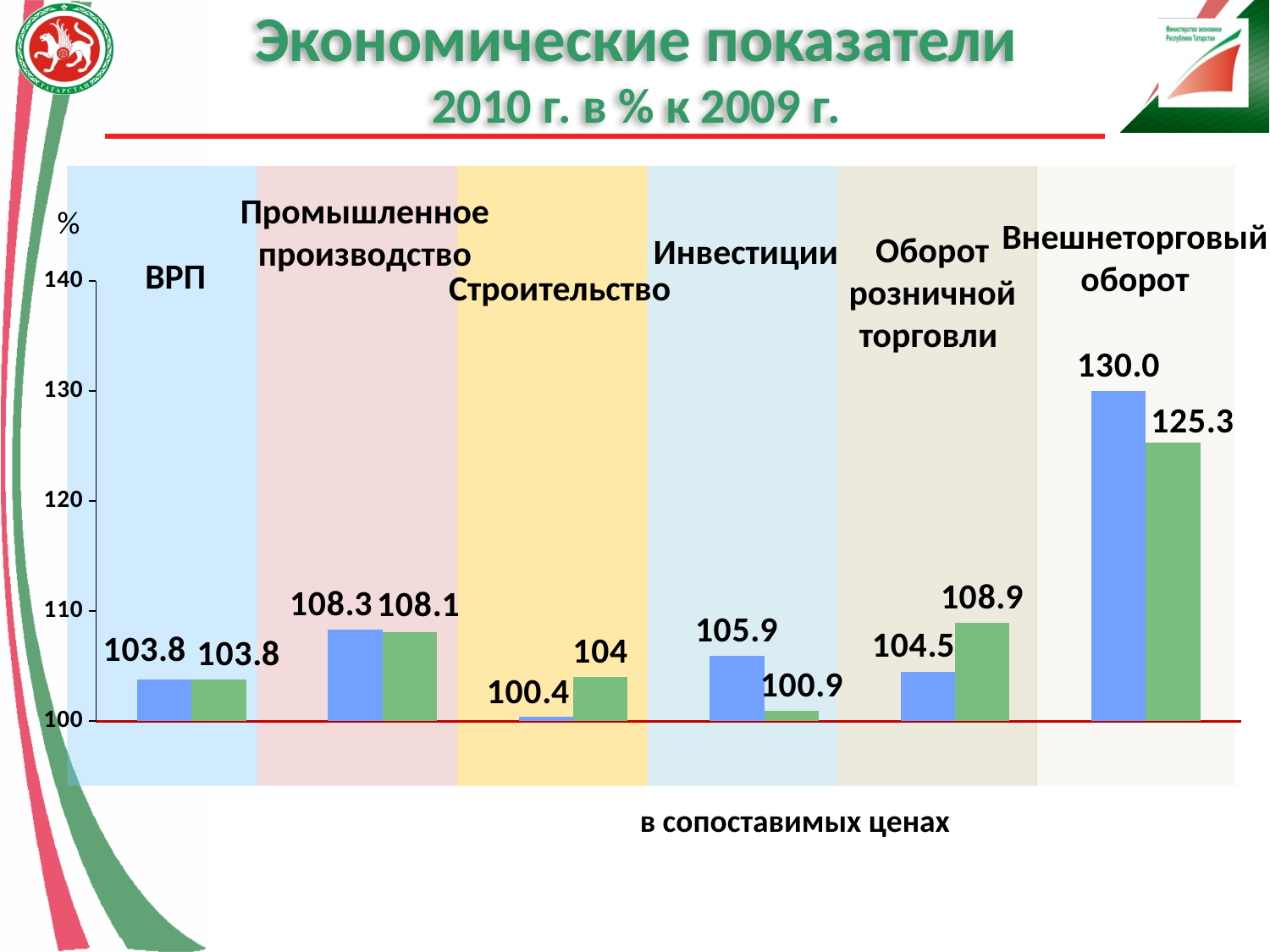
Is the value of the green bar for Внешнеторговый оборот greater or less than 120? greater Which category has the lowest blue bar? Строительство For Инвестиции, which bar is larger, the blue or the green? blue What is the value of the blue bar for Внешнеторговый оборот? 130.0 What is the value of the green bar for Оборот розничной торговли? 108.9 What is the value of the green bar for Инвестиции? 100.9 What type of chart is shown on the slide? bar chart Which category has the highest blue bar? Внешнеторговый оборот What is the value of the blue bar for Строительство? 100.4 How many categories are shown on the chart? 6 What is the difference between the blue and green bars for Внешнеторговый оборот? 4.7 Which category has the lowest green bar? Инвестиции